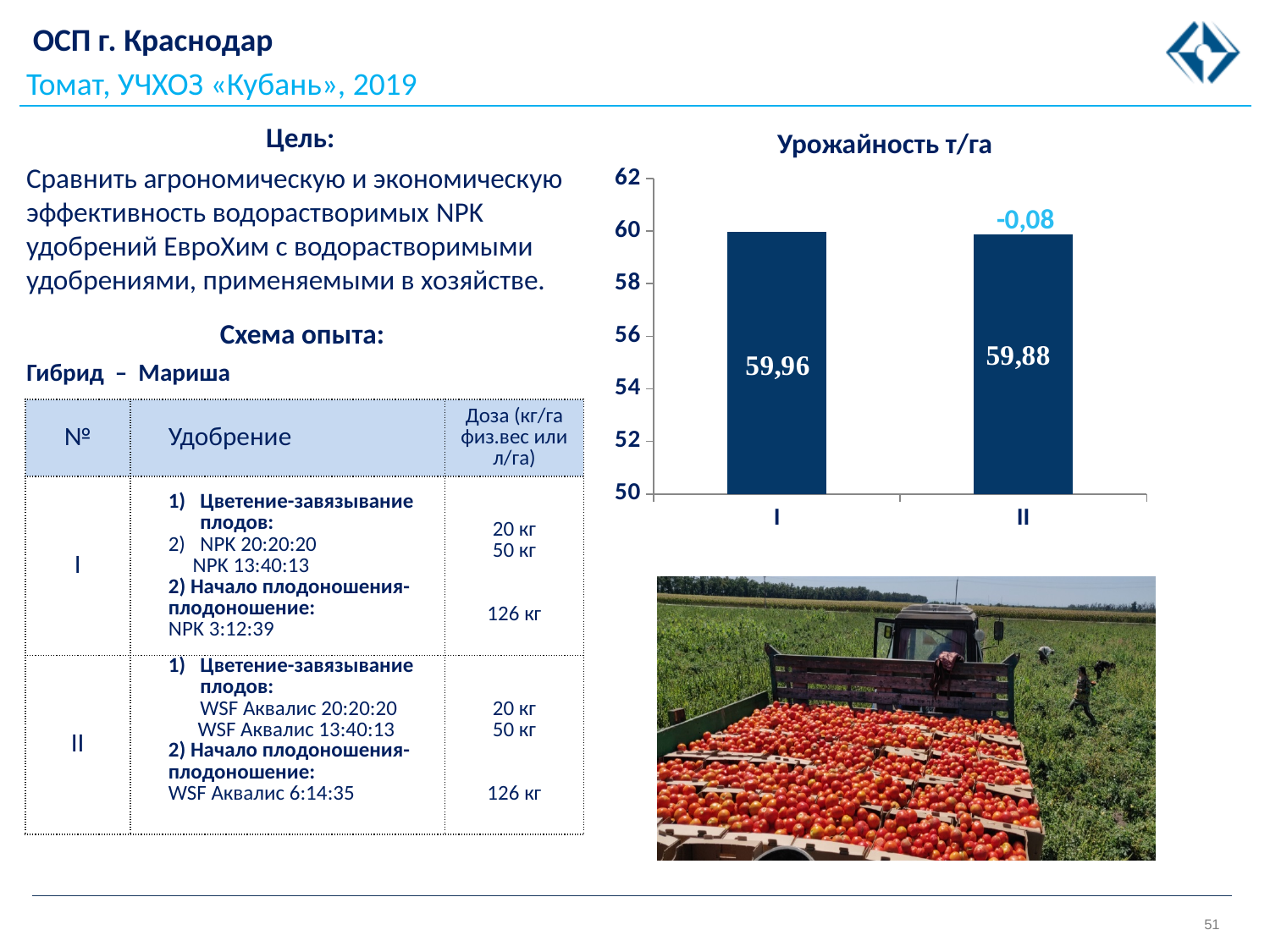
What kind of chart is "Урожайность т/га"? bar chart Is the value for I in the chart "Урожайность т/га" greater or less than 58? greater In the chart "Урожайность т/га", which is larger, the value for I or the value for II? I Which category has the highest value in the chart "Урожайность т/га"? I How many categories are shown in the chart "Урожайность т/га"? 2 What is the title of the chart on the slide? Урожайность т/га What annotation is printed above the bar for II in the chart "Урожайность т/га"? -0,08 What is the difference between the values for I and II in the chart "Урожайность т/га"? 0,08 Is the value for II in the chart "Урожайность т/га" greater or less than 60? less What is the value for category I in the chart "Урожайность т/га"? 59,96 Which category has the lowest value in the chart "Урожайность т/га"? II What is the value for category II in the chart "Урожайность т/га"? 59,88